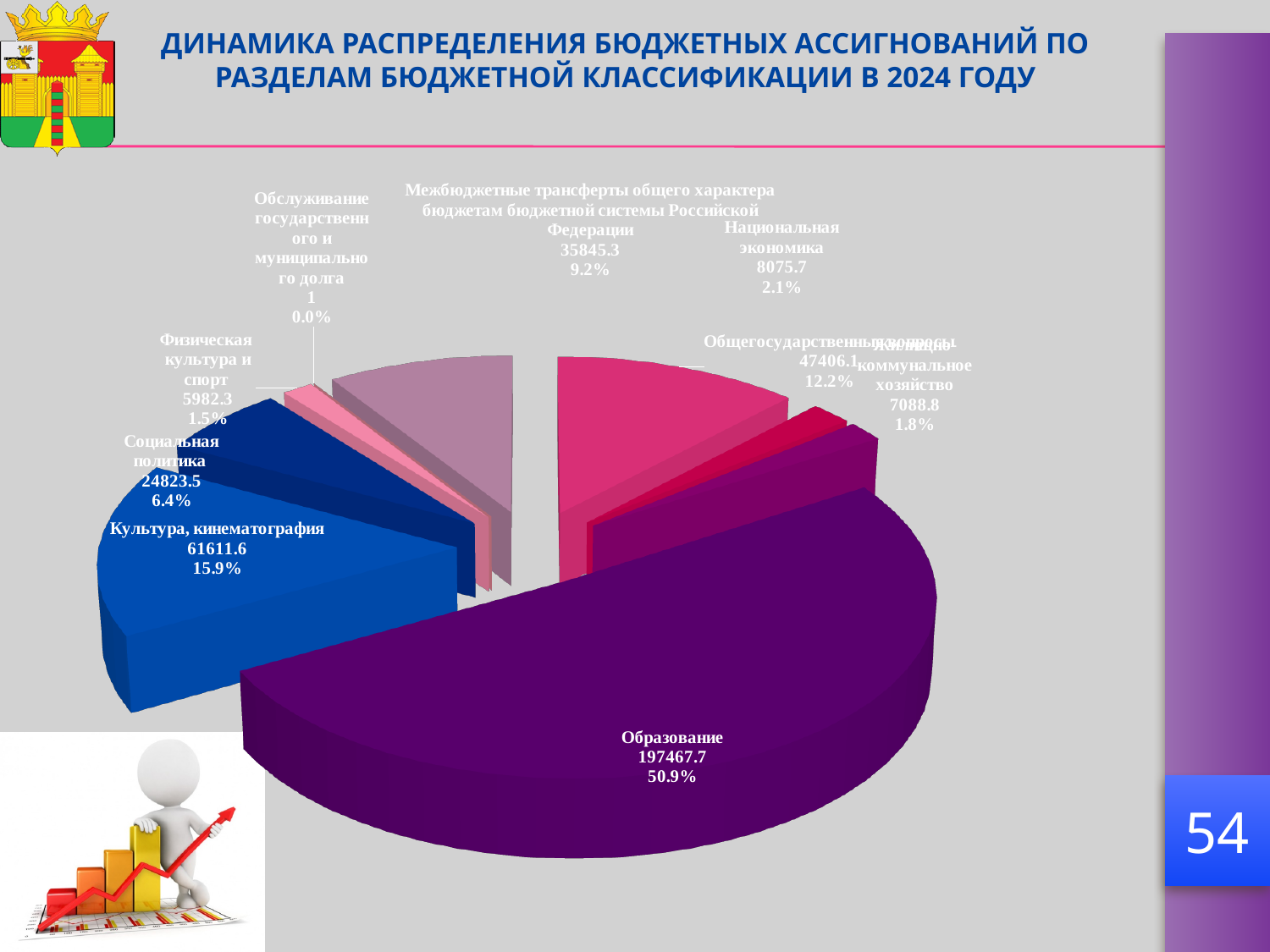
What value is shown for Культура, кинематография? 61611.6 What is the difference in percentage points between the share of Культура, кинематография and the share of Социальная политика? 9.5% Which category has the smallest share of the pie? Обслуживание государственного и муниципального долга How many categories are shown in the pie chart? 9 Which is larger: the value for Социальная политика or the value for Межбюджетные трансферты общего характера бюджетам бюджетной системы Российской Федерации? Межбюджетные трансферты общего характера бюджетам бюджетной системы Российской Федерации Which category has the largest share of the pie? Образование What value is shown for Образование? 197467.7 What kind of chart is shown on the slide? Pie chart What share of the pie does Образование represent? 50.9% What value is shown for Национальная экономика? 8075.7 What share of the pie does Социальная политика represent? 6.4% What year does the chart title refer to? 2024